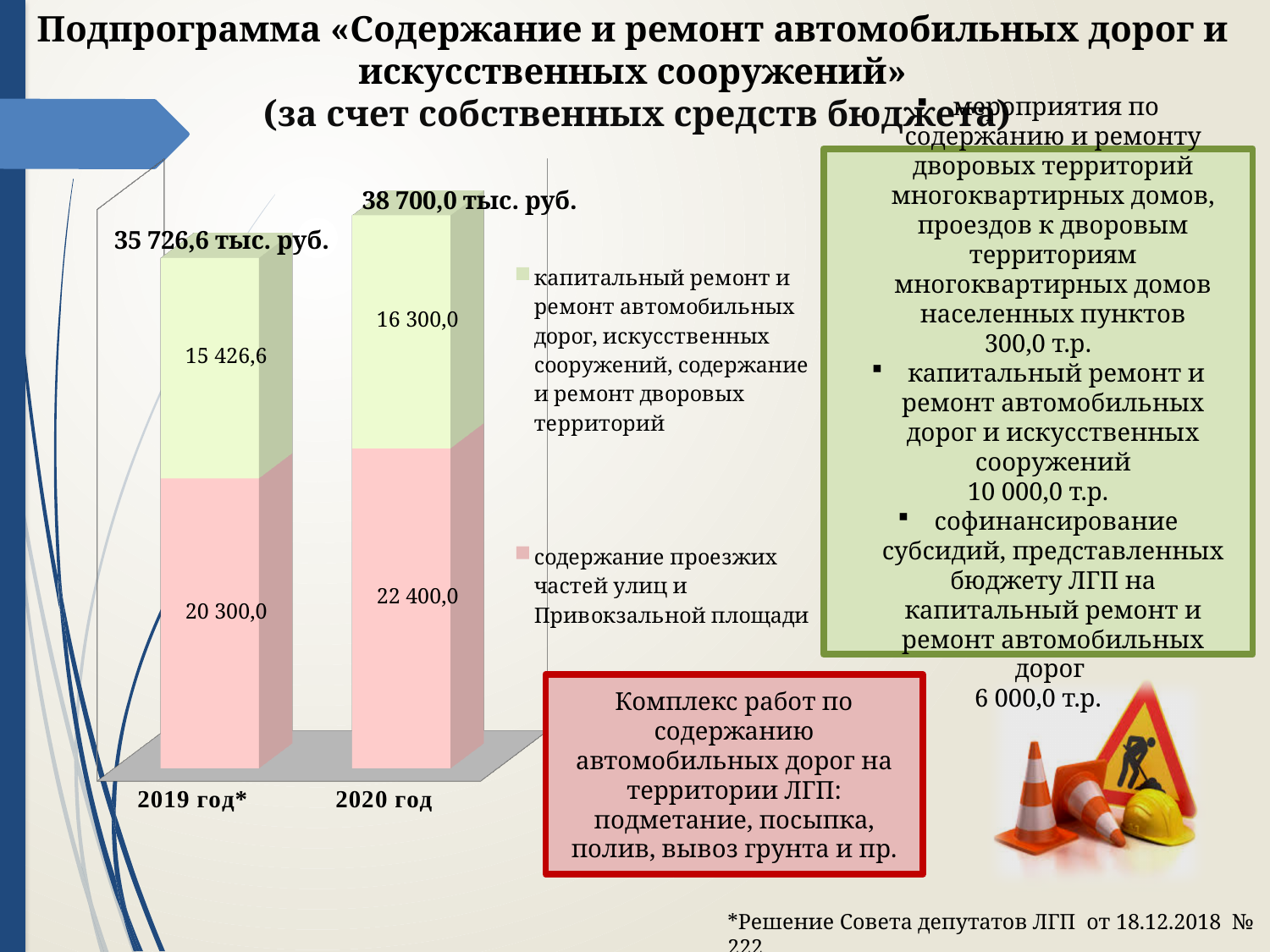
How many series does the chart legend list? 2 What type of chart is shown on the slide? stacked bar chart What is the value for "капитальный ремонт и ремонт автомобильных дорог, искусственных сооружений, содержание и ремонт дворовых территорий" in 2019 год*? 15 426,6 By how much does the value for "содержание проезжих частей улиц и Привокзальной площади" in 2020 год exceed that in 2019 год*? 2 100,0 How many categories (years) are shown on the x axis of the chart? 2 What is the value for "содержание проезжих частей улиц и Привокзальной площади" in 2020 год? 22 400,0 Which year has the higher total value? 2020 год What is the total of the stacked bar for 2020 год? 38 700,0 тыс. руб. Does the total value rise or fall from 2019 год* to 2020 год? rise What is the value for "капитальный ремонт и ремонт автомобильных дорог, искусственных сооружений, содержание и ремонт дворовых территорий" in 2020 год? 16 300,0 What is the value for "содержание проезжих частей улиц и Привокзальной площади" in 2019 год*? 20 300,0 What is the total of the stacked bar for 2019 год*? 35 726,6 тыс. руб.